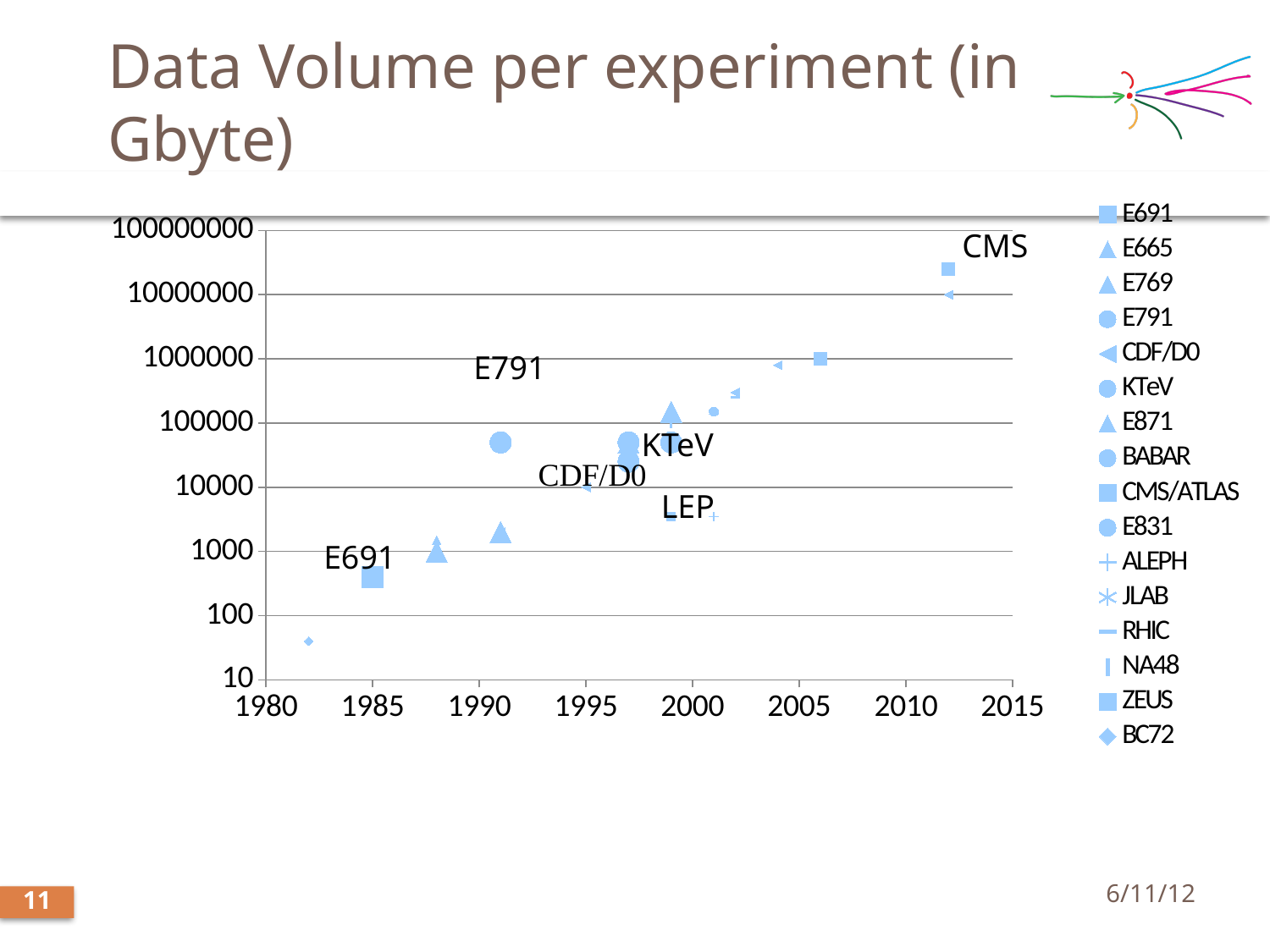
Is the data volume for KTeV greater or less than 10000? greater Is the data volume for E691 greater or less than 1000? less Which has the larger data volume, CMS or E691? CMS Do the data volumes generally rise or fall as the year increases along the x axis? rise How many entries does the legend list? 16 Is the data volume for CMS greater or less than 10000000? greater What kind of chart is shown on the slide? scatter chart What is the title of the chart? Data Volume per experiment (in Gbyte) What is the highest value shown on the y axis? 100000000 Which labelled experiment has the highest data volume on the chart? CMS